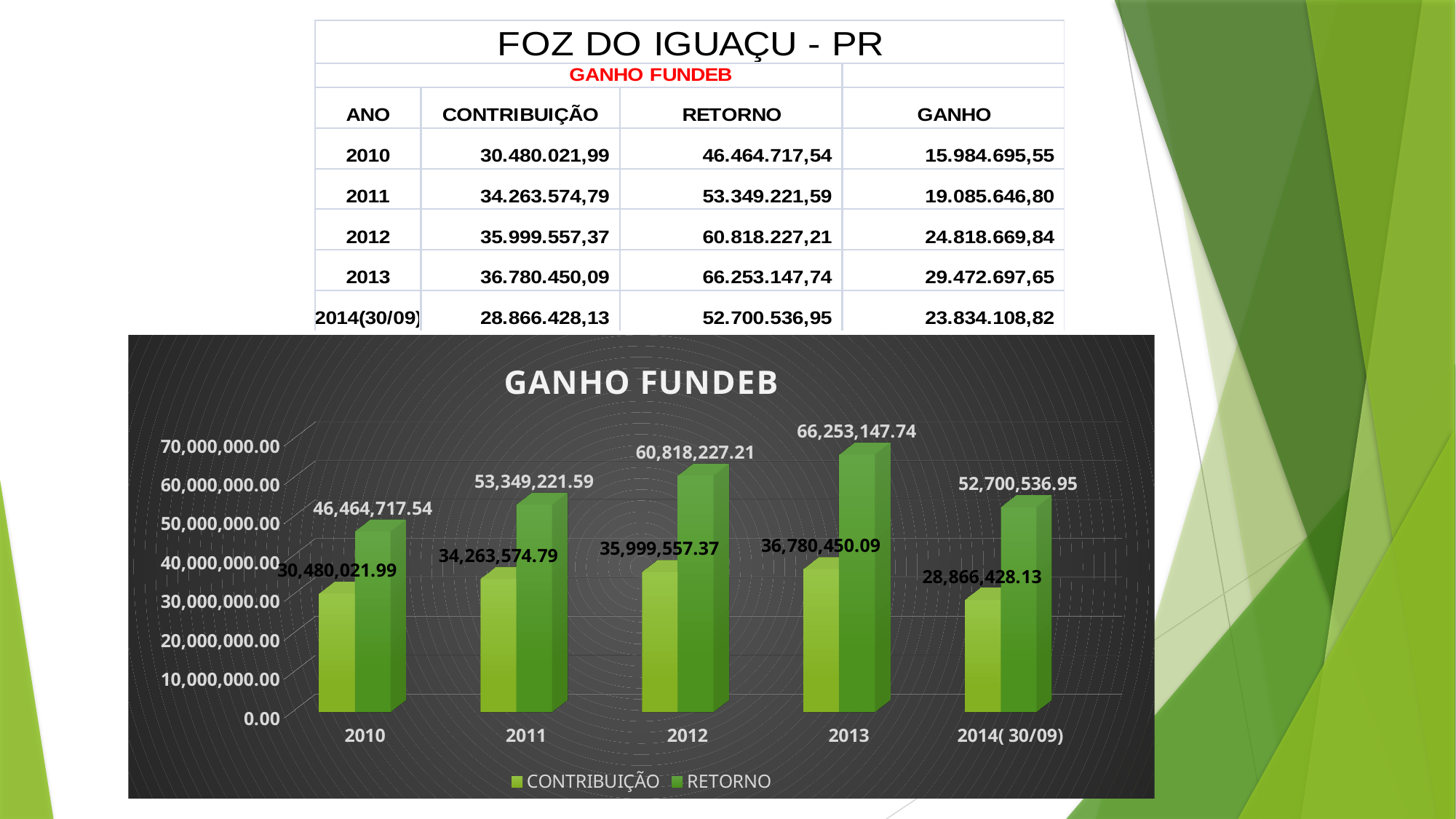
Does the CONTRIBUIÇÃO value rise or fall from 2010 to 2013 in the chart? rise What type of chart is shown on the slide? bar chart Which is larger in the chart: the RETORNO value for 2011 or the RETORNO value for 2014( 30/09)? 2011 What is the CONTRIBUIÇÃO value for 2011 in the chart? 34,263,574.79 What is the RETORNO value for 2014( 30/09) in the chart? 52,700,536.95 How many series does the chart legend list? 2 What is the difference between RETORNO and CONTRIBUIÇÃO for 2010 in the chart? 15,984,695.55 Which year has the lowest CONTRIBUIÇÃO value in the chart? 2014( 30/09) What is the RETORNO value for 2012 in the chart? 60,818,227.21 What is the title of the chart? GANHO FUNDEB How many year categories are shown on the x axis of the chart? 5 Which year has the highest RETORNO value in the chart? 2013